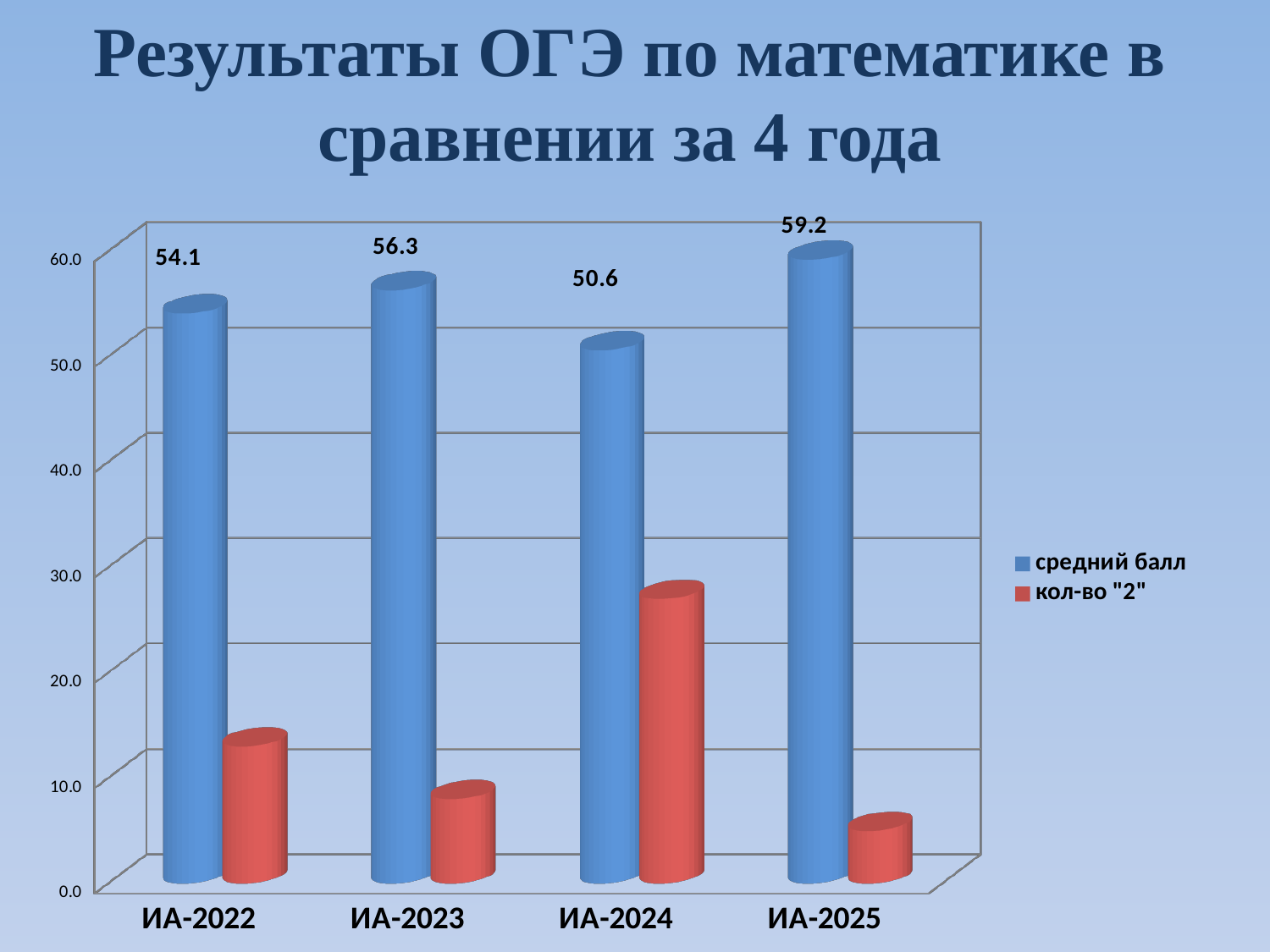
What is the average score (средний балл) for ИА-2023? 56.3 Which year has the lowest average score (средний балл)? ИА-2024 Is the value of кол-во "2" for ИА-2024 greater or less than 20? greater Is the value of кол-во "2" for ИА-2025 greater or less than 10? less What is the average score (средний балл) for ИА-2025? 59.2 How many series does the legend list? 2 What type of chart is shown on the slide? Bar chart Which year has the highest average score (средний балл)? ИА-2025 Which year has the lowest number of "2" grades (кол-во "2")? ИА-2025 Which year has the highest number of "2" grades (кол-во "2")? ИА-2024 What is the difference between the average score for ИА-2025 and ИА-2024? 8.6 What is the average score (средний балл) for ИА-2024? 50.6